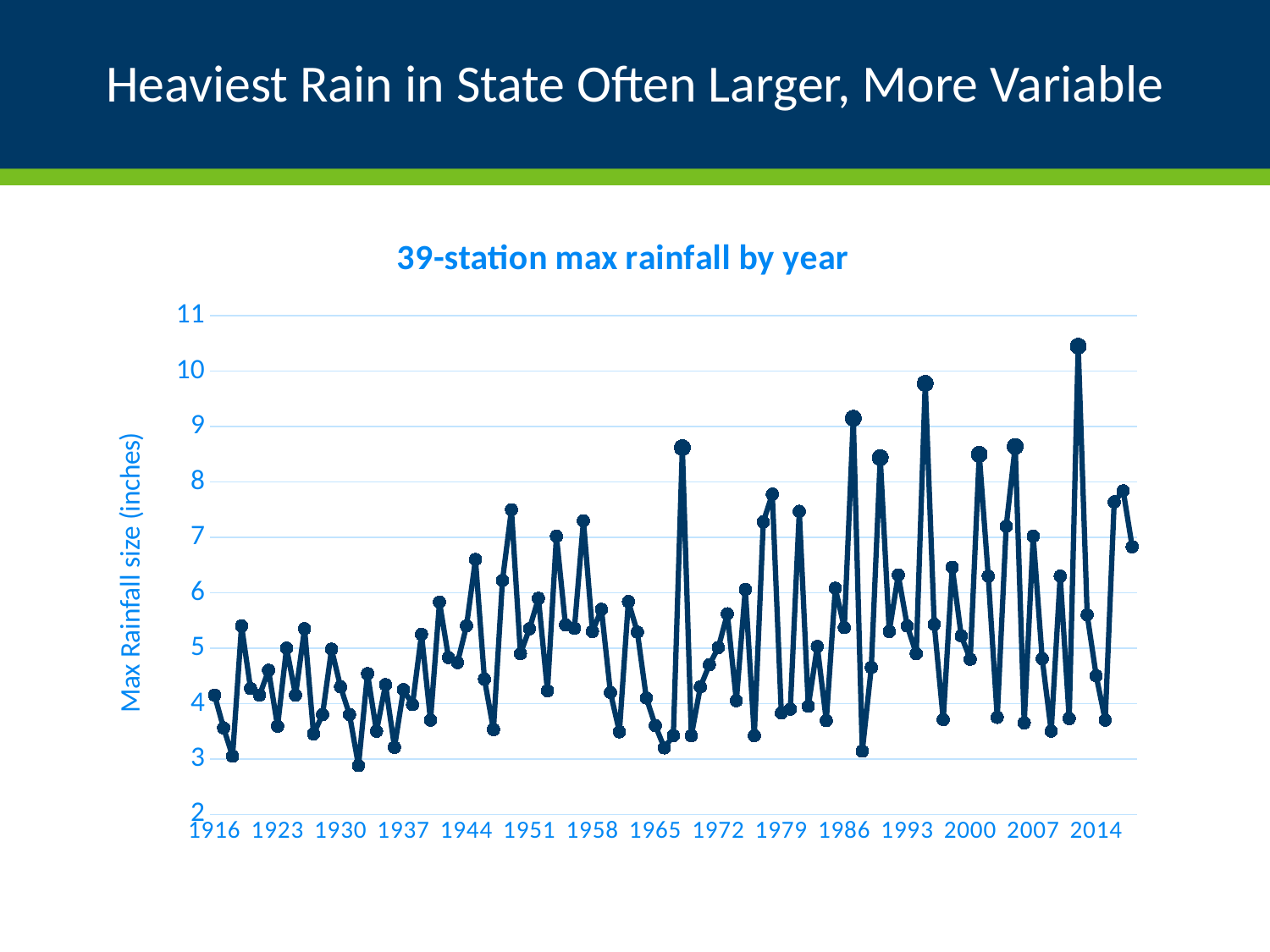
How many year labels are shown on the horizontal axis? 15 Is the value for 1965 greater or less than 4? less What is the highest value shown on the vertical axis? 11 What is the last year labelled on the horizontal axis? 2014 What kind of chart is shown on the slide? line chart Is the value for 1916 greater or less than 5? less What is the title of the chart? 39-station max rainfall by year What is the label on the vertical axis of the chart? Max Rainfall size (inches) How many data series are plotted on the chart? 1 What is the first year labelled on the horizontal axis? 1916 Is the value for 1986 greater or less than 8? less